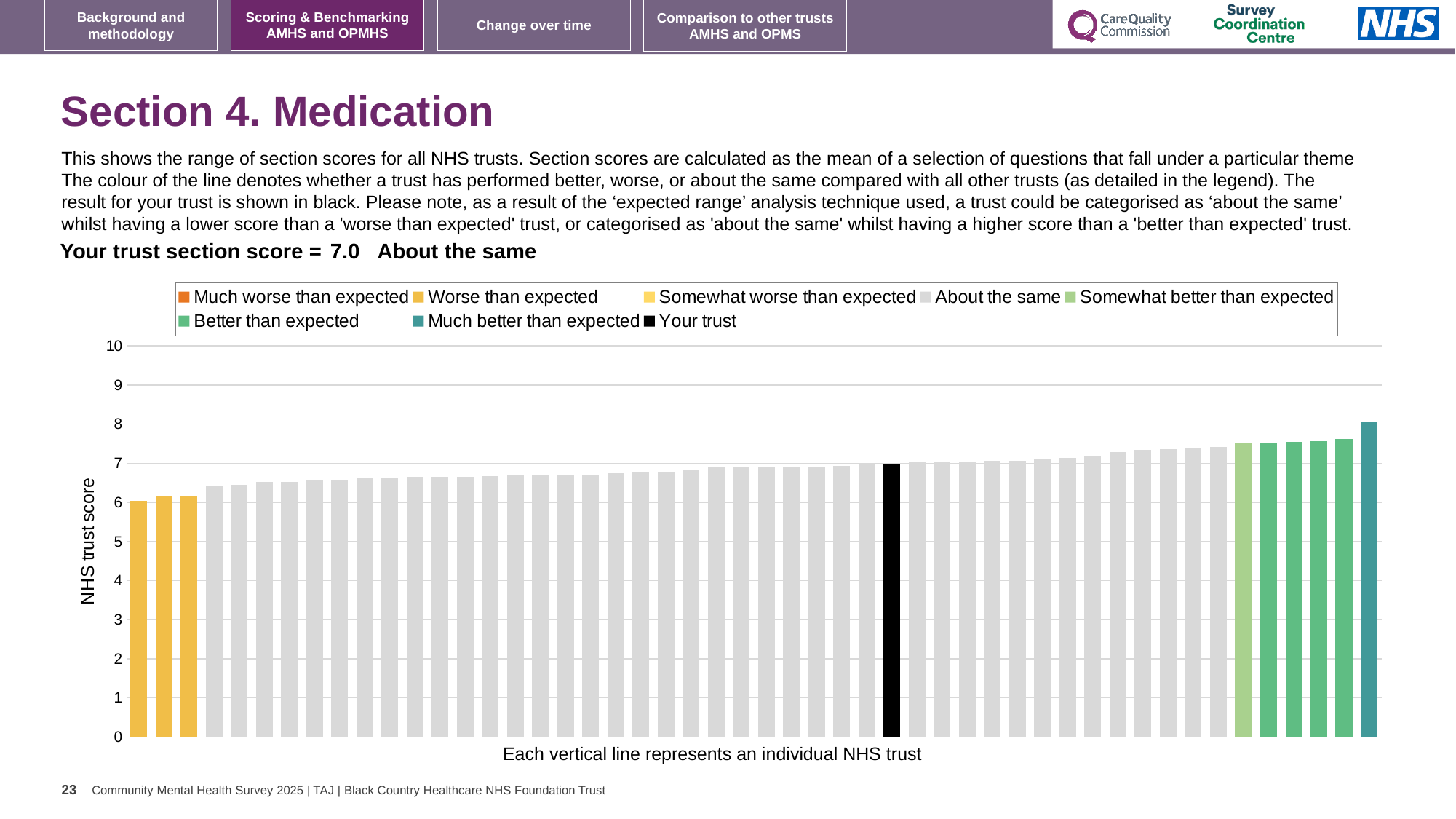
Which category is your trust placed in for Section 4 Medication? About the same What is the section score for your trust shown on the slide? 7.0 How many bars are coloured as 'Worse than expected'? 3 Which is higher, the black bar for your trust or the leftmost bar? the black bar for your trust What kind of chart is shown on the slide? bar chart How many bars are coloured as 'Much better than expected'? 1 Do the bar values rise or fall from left to right along the x axis? rise How many entries does the chart legend list? 8 Is the value of the leftmost bar greater or less than 7? less What is the label on the vertical axis of the chart? NHS trust score Is the value of the rightmost bar greater or less than 7? greater Is the value of the leftmost bar greater or less than 5? greater